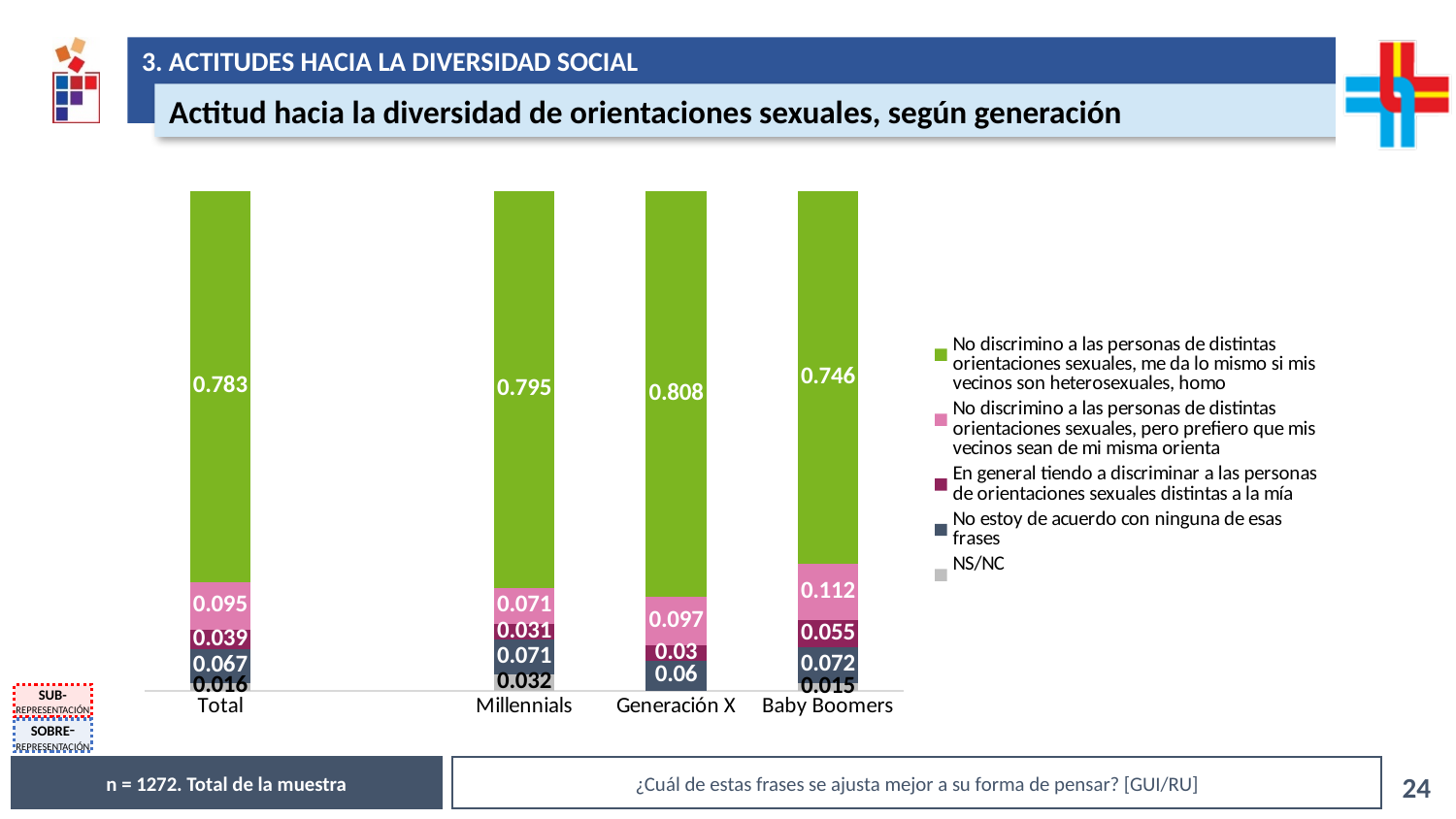
What is the value of the pink segment ("...pero prefiero que mis vecinos sean de mi misma orienta") for Baby Boomers? 0.112 What is the difference between the green segment values for Millennials and Baby Boomers? 0.049 Which category has the highest value for the green segment ("No discrimino... me da lo mismo")? Generación X How many series does the chart legend list? 5 Which category has the highest value for the "En general tiendo a discriminar" segment? Baby Boomers How many categories are shown on the x axis of the chart? 4 What is the value of the "No estoy de acuerdo con ninguna de esas frases" segment for Total? 0.067 What is the value of the NS/NC segment for Millennials? 0.032 What kind of chart is shown on the slide? stacked bar chart Is the pink segment value for Total larger or smaller than the pink segment value for Millennials? larger Which category has the lowest value for the green segment ("No discrimino... me da lo mismo")? Baby Boomers What is the value of the green segment ("No discrimino a las personas de distintas orientaciones sexuales, me da lo mismo...") for Generación X? 0.808